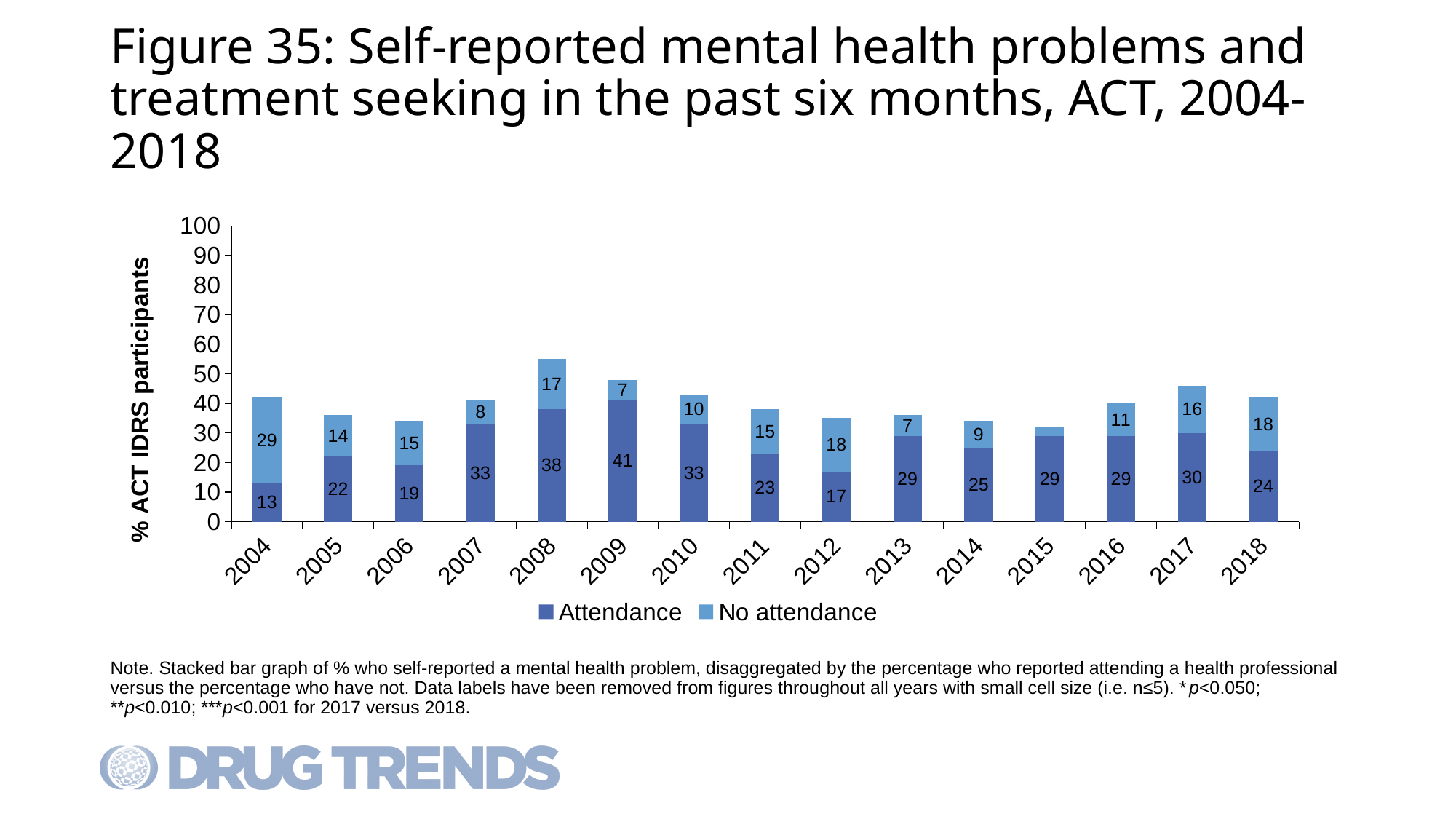
How many series does the legend list? 2 Which year has the highest No attendance value? 2004 What is the No attendance value for 2004? 29 What is the Attendance value for 2009? 41 Which is larger, the Attendance value for 2008 or for 2010? 2008 What kind of chart is shown on the slide? Stacked bar chart What is the difference between the Attendance values for 2017 and 2018? 6 What is the Attendance value for 2018? 24 What is the total of the stacked bar for 2008? 55 Which year has the lowest Attendance value? 2004 Which year has the highest Attendance value? 2009 How many years are shown on the x axis? 15